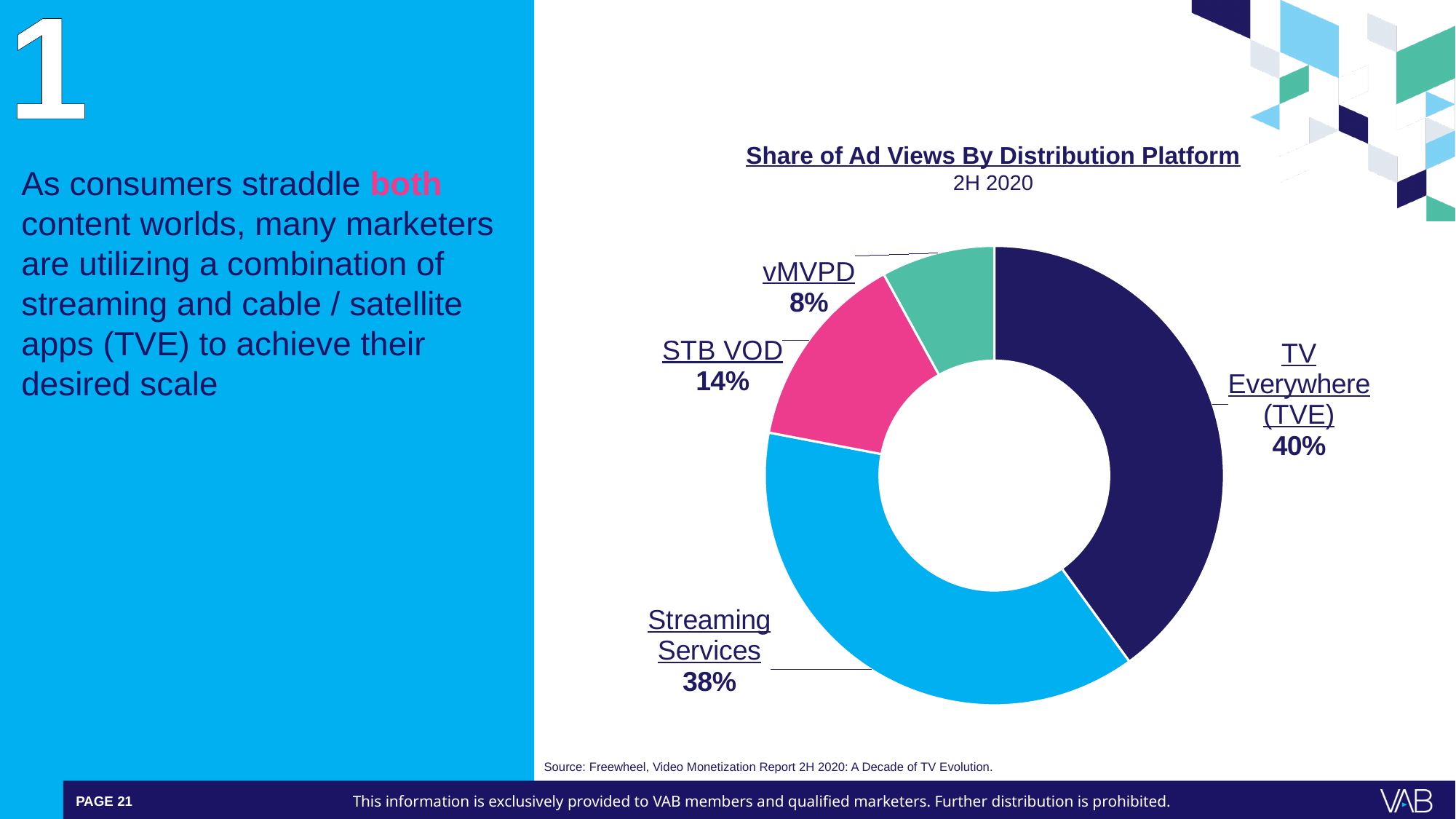
What is the difference in share between STB VOD and vMVPD? 6% Which has a larger share of ad views, STB VOD or vMVPD? STB VOD What share of ad views do Streaming Services have? 38% What share of ad views does TV Everywhere (TVE) have? 40% What period does the chart cover? 2H 2020 What share of ad views does STB VOD have? 14% What is the difference in share between TV Everywhere (TVE) and Streaming Services? 2% Which distribution platform has the largest share of ad views? TV Everywhere (TVE) How many distribution platforms are shown in the chart? 4 What kind of chart is shown on the slide? Pie chart (donut) What share of ad views does vMVPD have? 8% Which distribution platform has the smallest share of ad views? vMVPD